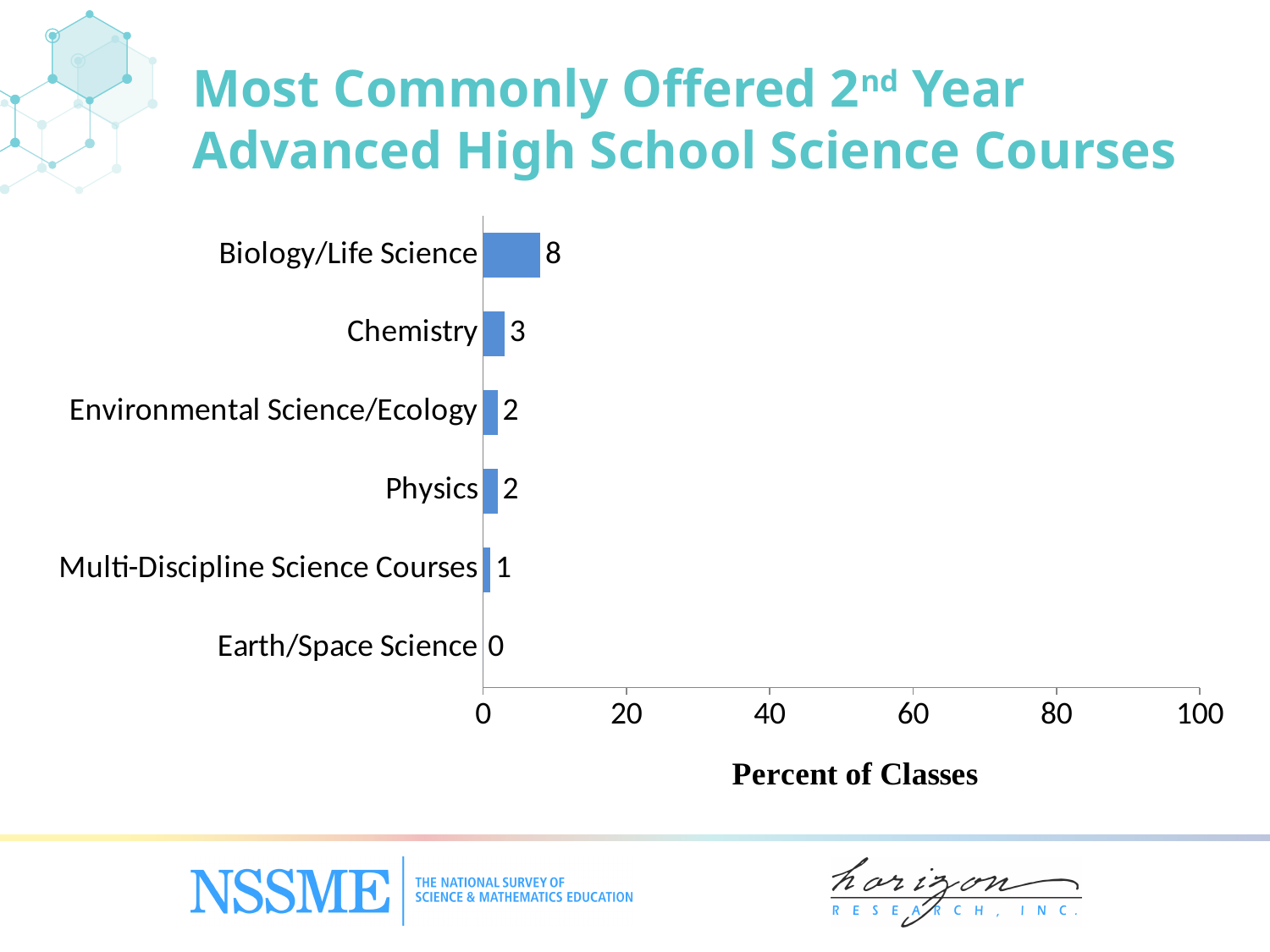
What is the value for Biology/Life Science? 8 Is the value for Biology/Life Science greater or less than 20? less What is the difference between the values for Biology/Life Science and Chemistry? 5 Which is larger, the value for Chemistry or the value for Physics? Chemistry What is the value for Multi-Discipline Science Courses? 1 What is the value for Chemistry? 3 How many categories are shown in the chart? 6 What is the label of the horizontal axis? Percent of Classes What kind of chart is shown on the slide? bar chart Which category has the highest value? Biology/Life Science What is the value for Earth/Space Science? 0 Which category has the lowest value? Earth/Space Science